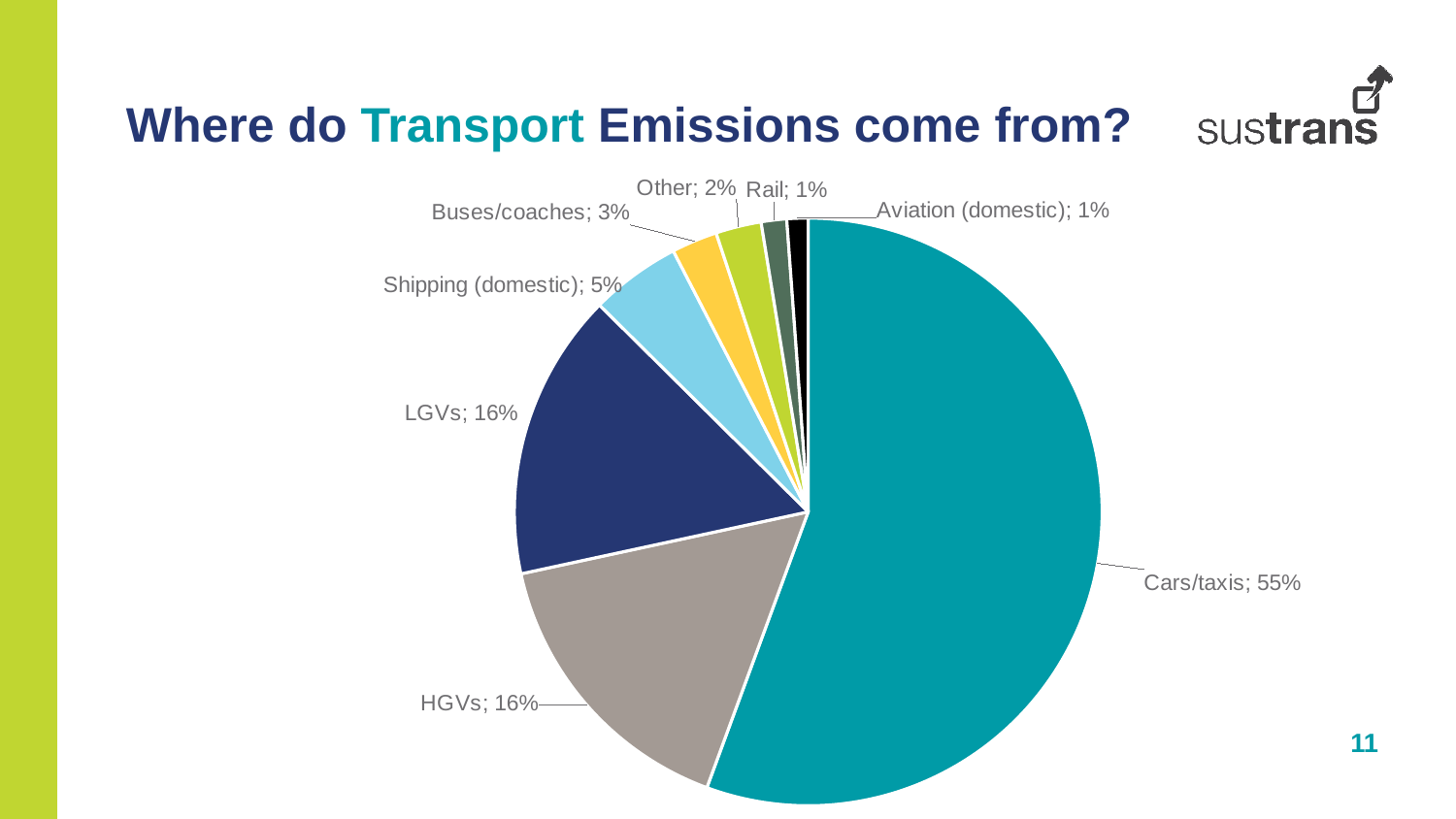
What share of transport emissions comes from LGVs? 16% What share of transport emissions comes from Other? 2% Which category accounts for the largest share of transport emissions? Cars/taxis Which is larger, the share for Shipping (domestic) or the share for Buses/coaches? Shipping (domestic) What is the difference in percentage points between the Cars/taxis share and the HGVs share? 39 What kind of chart is shown on the slide? Pie chart What share of transport emissions comes from Buses/coaches? 3% What is the title of the slide containing the chart? Where do Transport Emissions come from? What share of transport emissions comes from Cars/taxis? 55% What share of transport emissions comes from Shipping (domestic)? 5% What is the combined share of LGVs and HGVs? 32% How many categories are shown in the pie chart? 8